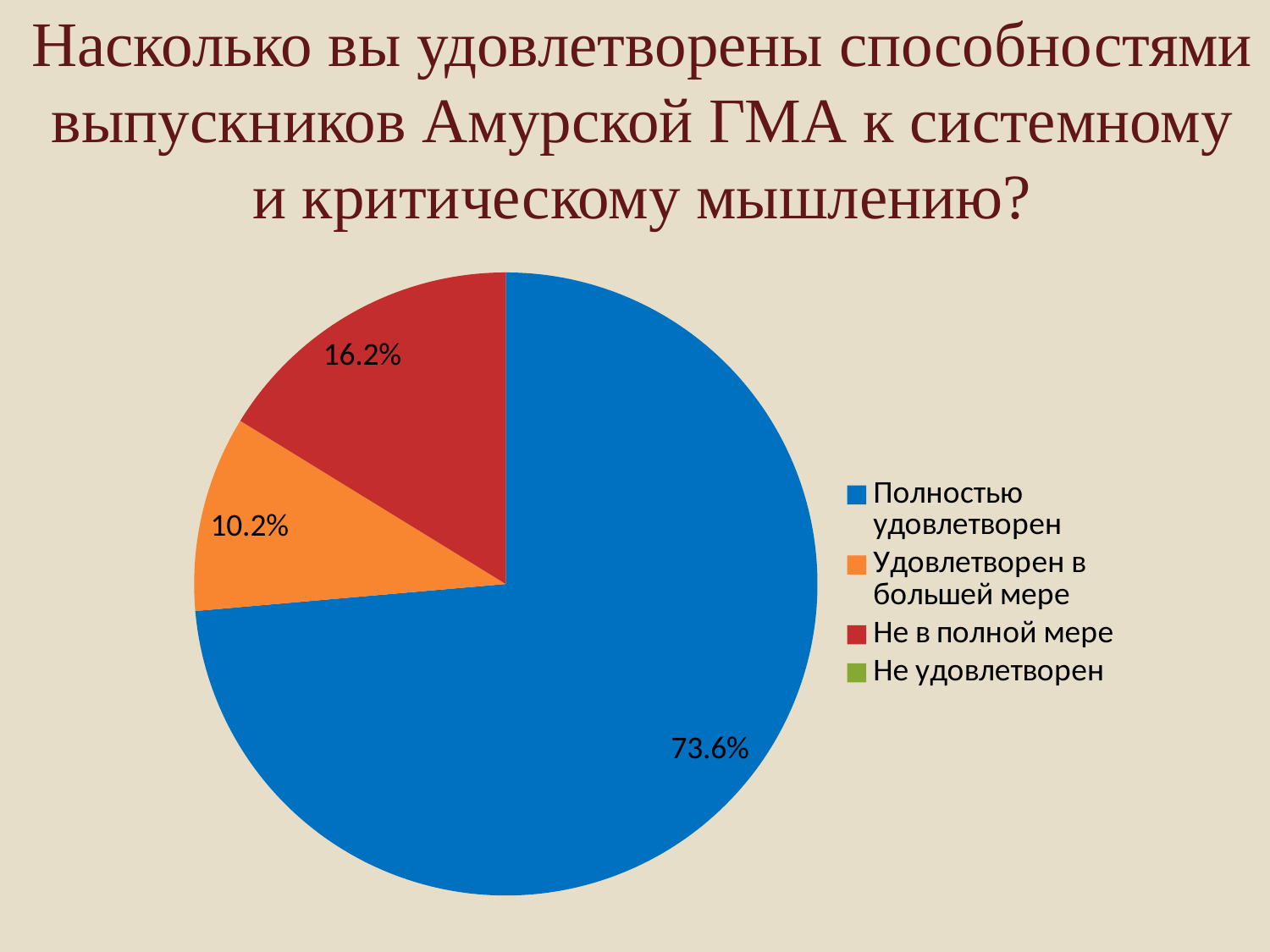
What share of respondents answered "Полностью удовлетворен"? 73.6% What colour is the slice for "Полностью удовлетворен"? Blue Which slice is larger: "Не в полной мере" or "Удовлетворен в большей мере"? Не в полной мере What share of respondents answered "Не в полной мере"? 16.2% How many slices with data labels are visible in the pie? 3 What share of respondents answered "Удовлетворен в большей мере"? 10.2% What is the difference in percentage points between "Полностью удовлетворен" and "Не в полной мере"? 57.4 How many entries does the legend list? 4 What is the difference in percentage points between "Не в полной мере" and "Удовлетворен в большей мере"? 6 What kind of chart is shown on the slide? Pie chart Which of the labelled slices is the smallest? Удовлетворен в большей мере Which response category has the largest slice of the pie? Полностью удовлетворен